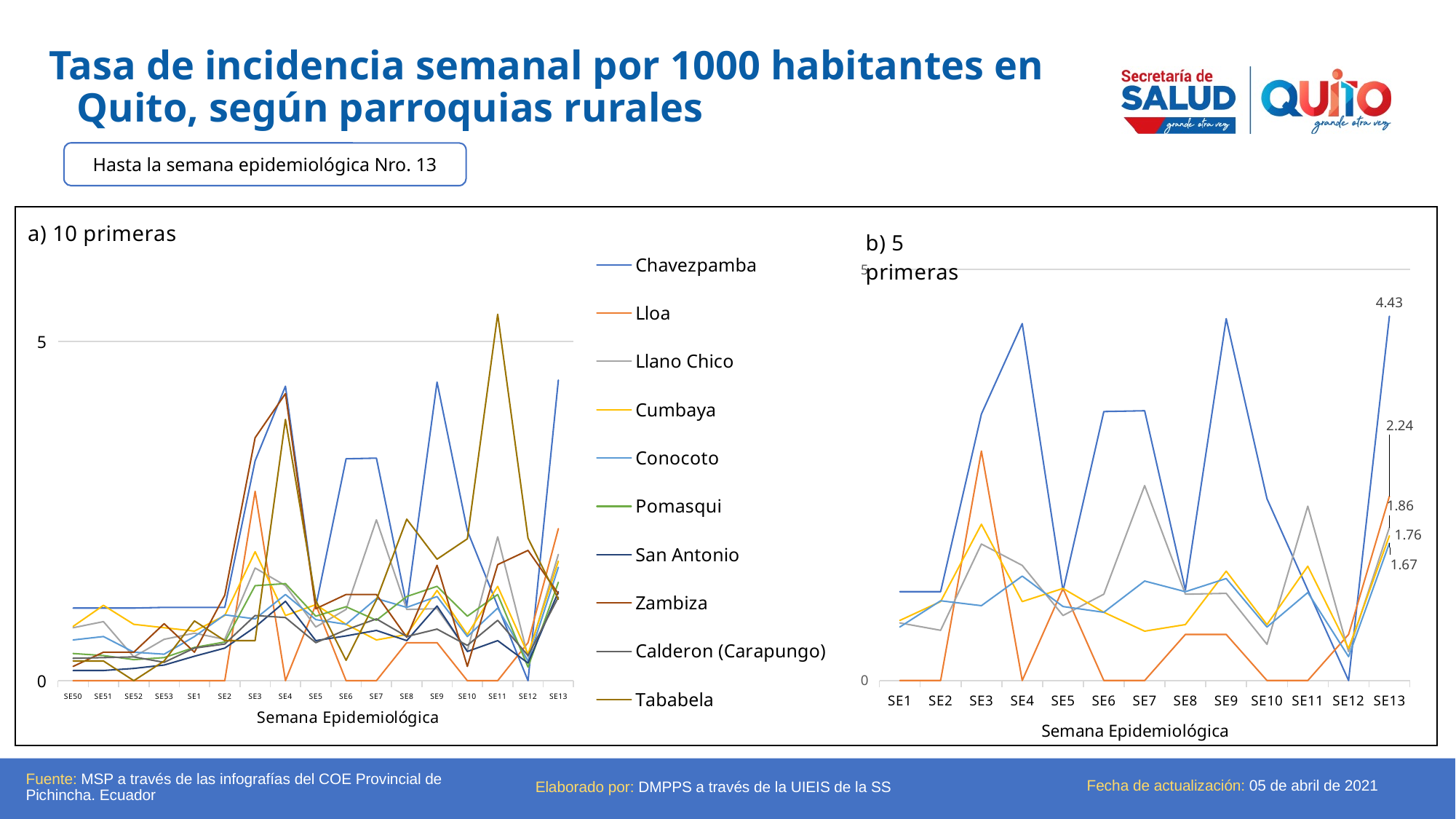
What is the first series listed in the legend of chart a) "10 primeras"? Chavezpamba How many epidemiological weeks are shown on the x axis of chart b) "5 primeras"? 13 In chart b) "5 primeras", what is the difference between the highest (4.43) and lowest (1.67) values labeled at SE13? 2.76 In chart b) "5 primeras", what is the difference between the labeled values 2.24 and 1.86 at SE13? 0.38 In chart a) "10 primeras", is the value for Tababela at SE11 greater or less than 5? greater In chart a) "10 primeras", which series reaches the highest peak on the chart? Tababela How many series does the legend of chart a) "10 primeras" list? 10 In chart b) "5 primeras", what is the lowest value labeled at SE13? 1.67 What kind of chart is chart a) "10 primeras"? line chart In chart b) "5 primeras", is the value of the blue line at SE4 greater or less than 5? less How many epidemiological weeks are shown on the x axis of chart a) "10 primeras"? 17 In chart b) "5 primeras", what is the highest value labeled at SE13? 4.43